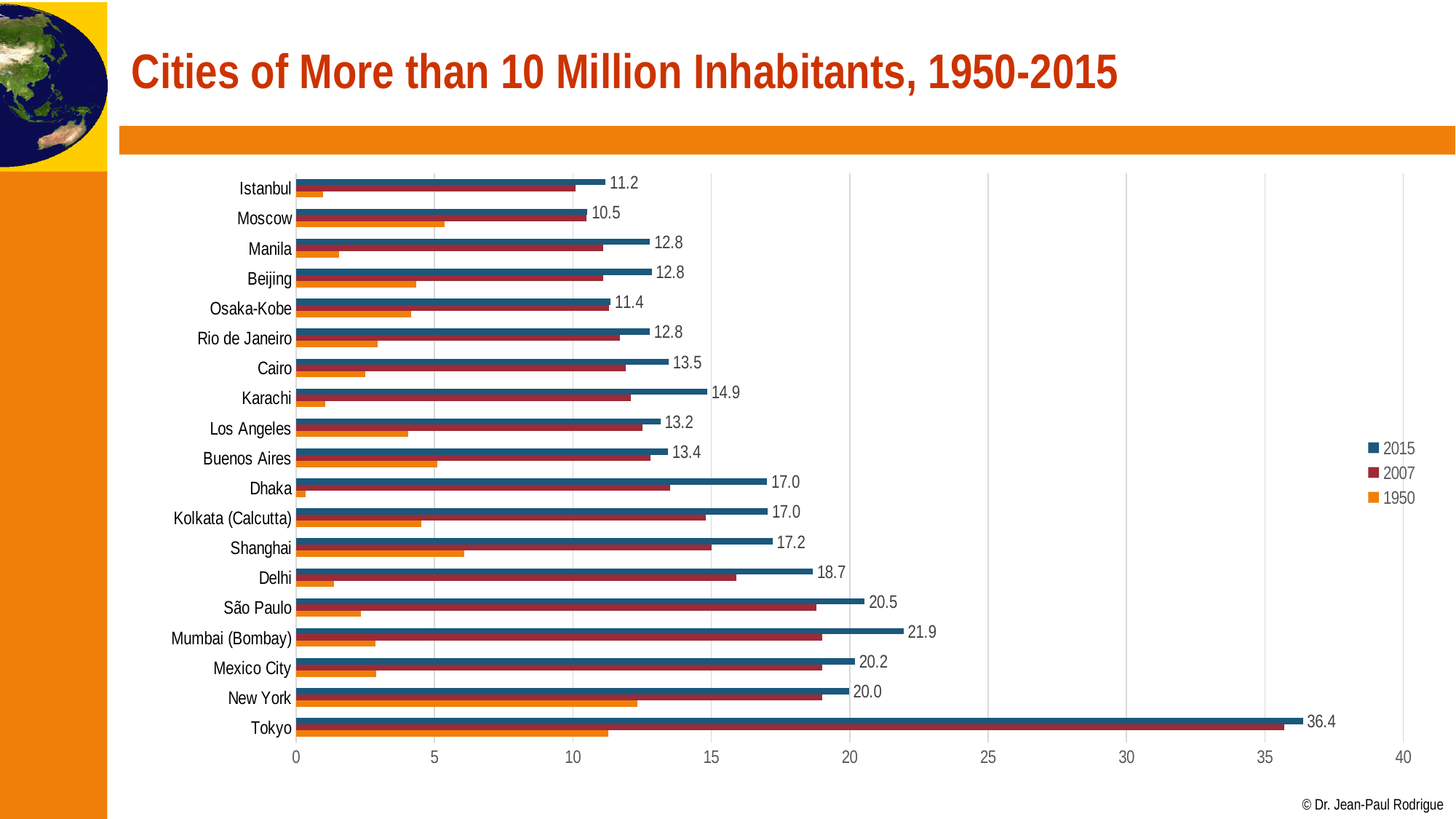
Which has the larger 2015 value, Delhi or Shanghai? Delhi What kind of chart is shown on the slide? Bar chart What is the 2015 value for Mumbai (Bombay)? 21.9 Which city has the lowest 2015 value? Moscow Is the 1950 value for Dhaka greater or less than 5? less What is the 2015 value for Karachi? 14.9 How many cities are shown on the chart? 19 How many series does the legend list? 3 Is the 1950 value for New York greater or less than 10? greater Which city has the highest 2015 value? Tokyo What is the 2015 value for Tokyo? 36.4 What is the difference between the 2015 values for Tokyo and New York? 16.4